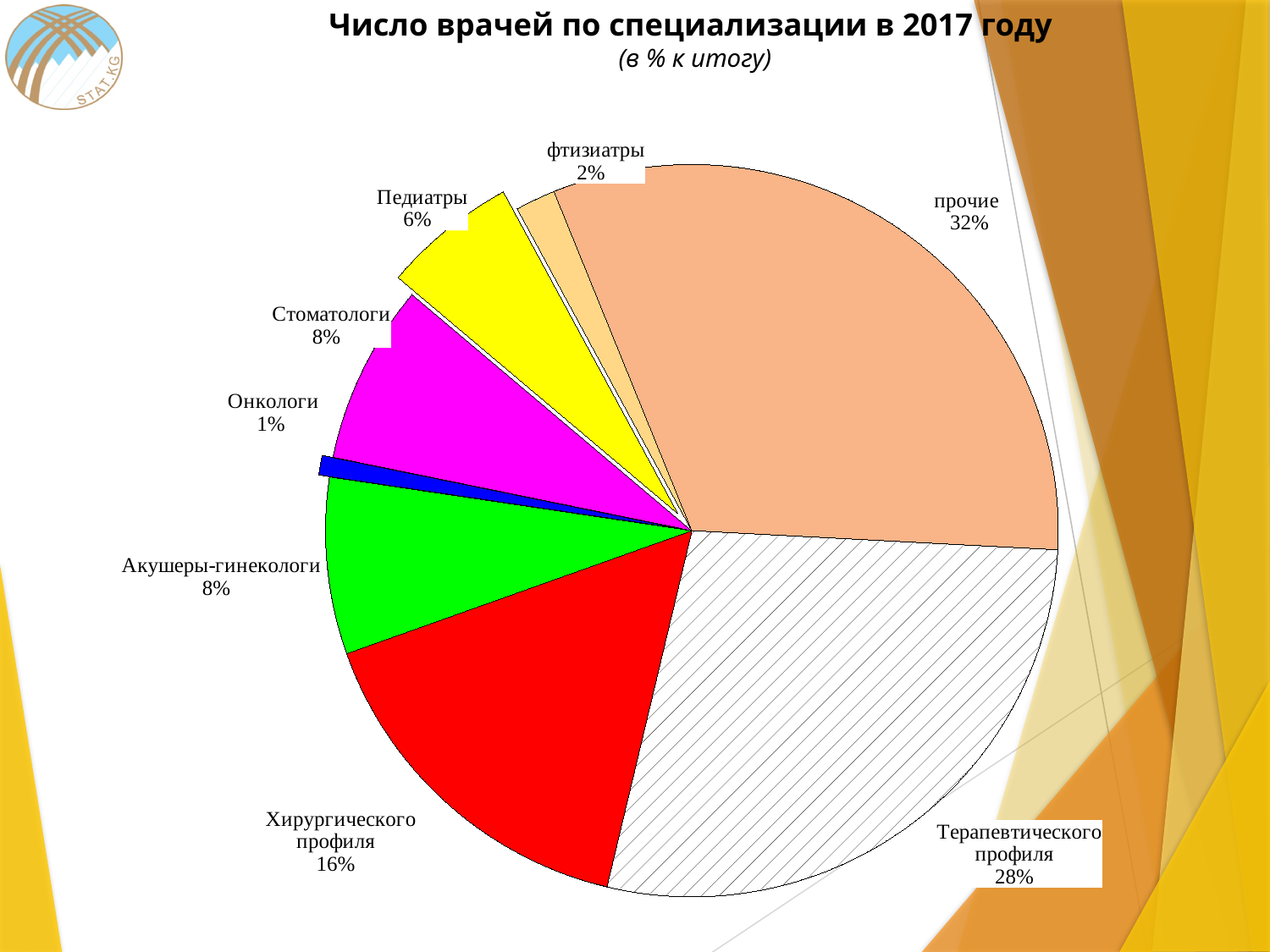
What percentage is shown for 'Педиатры'? 6% Which is larger, the share for 'Стоматологи' or the share for 'Педиатры'? Стоматологи What percentage is shown for 'фтизиатры'? 2% Which category has the smallest slice of the pie? Онкологи What share of doctors is 'Терапевтического профиля'? 28% What kind of chart is shown on the slide? pie chart What is the title of the chart? Число врачей по специализации в 2017 году What share of doctors is in the 'прочие' category? 32% Which category has the largest slice of the pie? прочие What share of doctors is 'Хирургического профиля'? 16% How many categories (slices) does the pie chart have? 8 What is the difference in percentage points between 'Терапевтического профиля' and 'Хирургического профиля'? 12